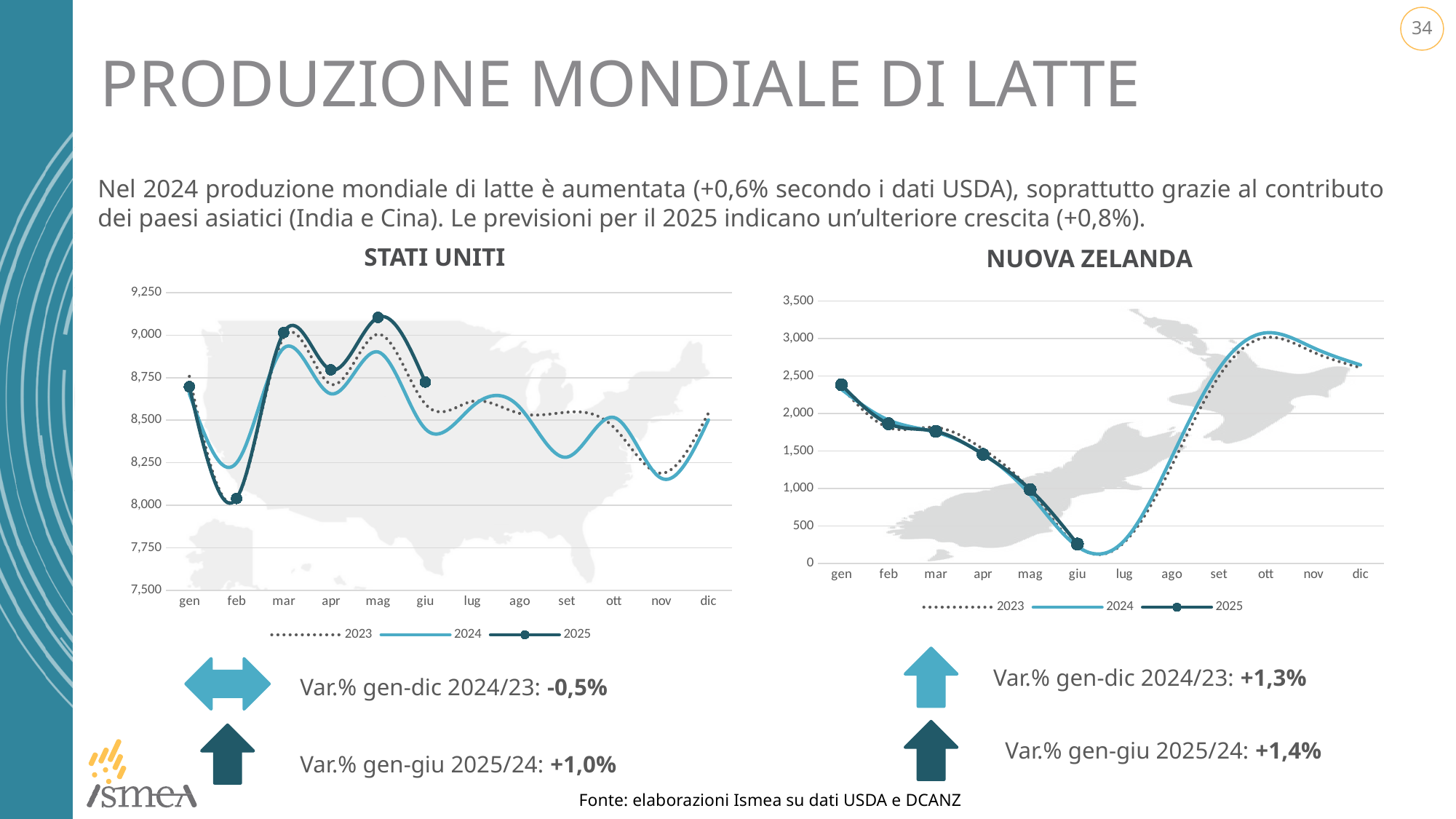
In the STATI UNITI chart, which is larger for the 2025 series: the value for feb or the value for mar? mar How many months are shown on the x axis of the STATI UNITI chart? 12 How many series does the legend of the NUOVA ZELANDA chart list? 3 What kind of chart is the STATI UNITI chart? line chart In the NUOVA ZELANDA chart, is the 2024 value for lug greater or less than 500? less In the STATI UNITI chart, which month has the lowest value for the 2025 series? feb In the NUOVA ZELANDA chart, does the 2025 series rise or fall from gen to giu? fall In the NUOVA ZELANDA chart, which month has the lowest value for the 2025 series? giu In the STATI UNITI chart, is the 2025 value for feb greater or less than 8,250? less In the NUOVA ZELANDA chart, which month has the highest value for the 2025 series? gen In the NUOVA ZELANDA chart, how many data points does the 2025 series have? 6 In the STATI UNITI chart, is the 2025 value for mag greater or less than 9,000? greater